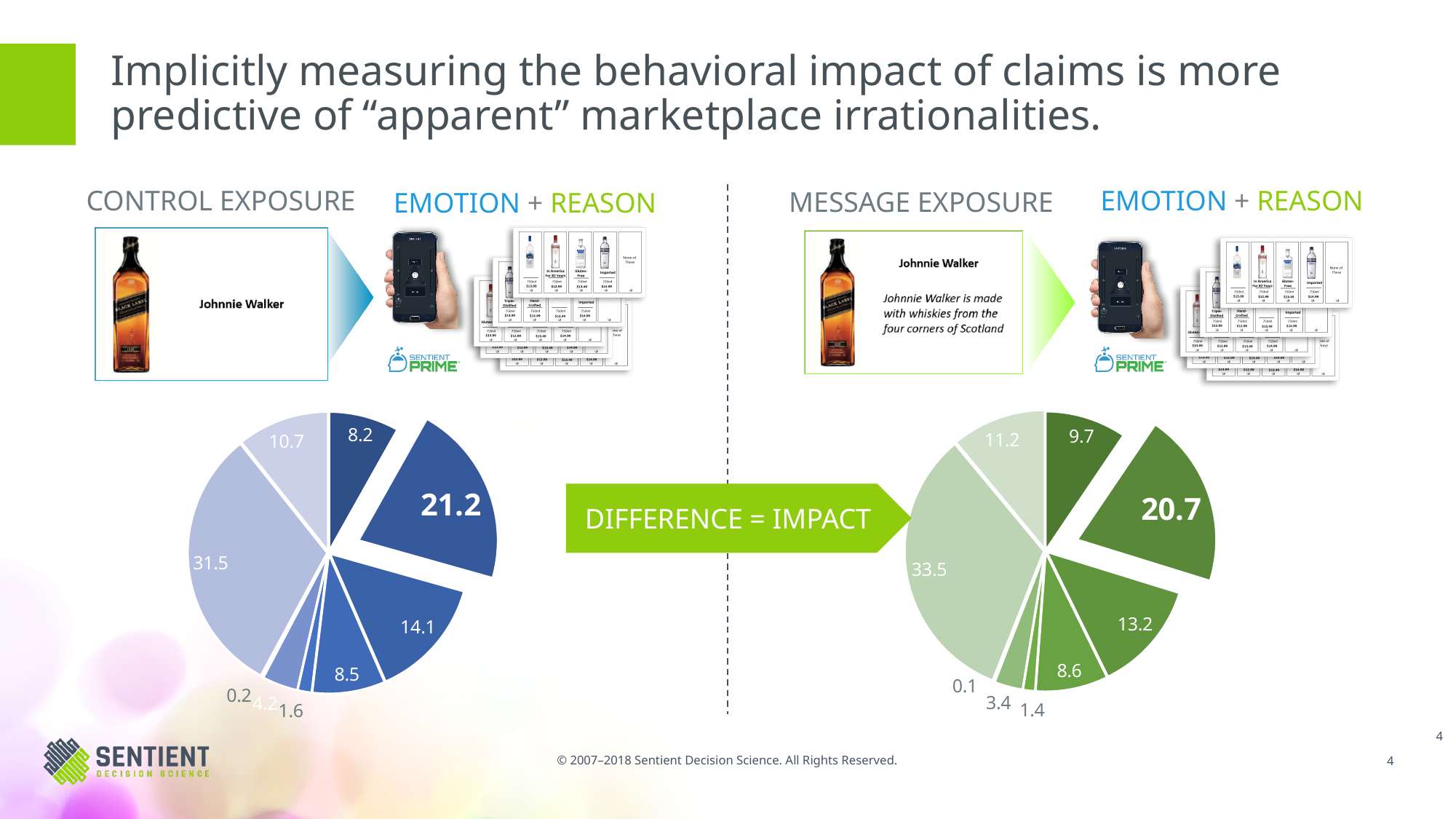
What kind of chart is shown on the left side of the slide under CONTROL EXPOSURE? Pie chart What is the largest value labelled in the left (blue) pie chart? 31.5 Which is larger: the largest slice of the left (blue) pie chart or the largest slice of the right (green) pie chart? The right (green) pie chart's largest slice, 33.5 In the right (green) pie chart, what value is shown on the exploded slice? 20.7 What kind of chart is shown on the right side of the slide under MESSAGE EXPOSURE? Pie chart What is the smallest value labelled in the right (green) pie chart? 0.1 In the left (blue) pie chart, what value is shown on the exploded slice? 21.2 What is the largest value labelled in the right (green) pie chart? 33.5 How many slices does the left (blue) pie chart have? 9 What is the difference between the exploded slice value in the left pie chart (21.2) and the exploded slice value in the right pie chart (20.7)? 0.5 What is the smallest value labelled in the left (blue) pie chart? 0.2 What text is written in the green arrow between the two pie charts? DIFFERENCE = IMPACT